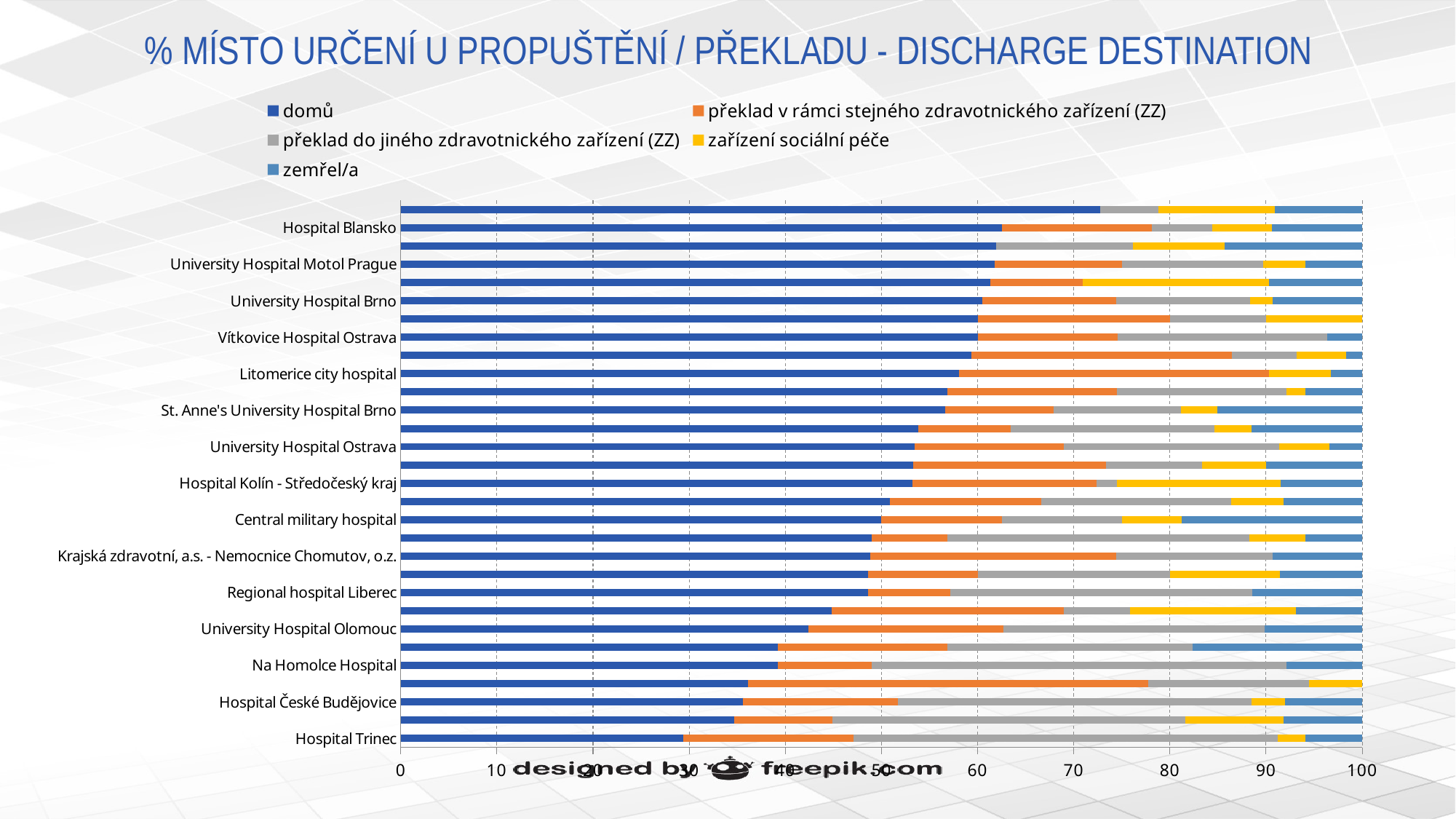
Do the 'domů' values increase or decrease going from the top bar to the bottom bar? decrease Which has a larger 'domů' share, Na Homolce Hospital or University Hospital Brno? University Hospital Brno What value does each stacked bar total on the x axis? 100 Is the 'domů' value for Hospital Blansko greater or less than 60? greater Is the 'domů' value for Hospital České Budějovice greater or less than 40? less What kind of chart is shown on the slide? Stacked bar chart How many series does the legend list? 5 Is the 'domů' value for Hospital Trinec greater or less than 40? less Which labeled hospital has the lowest 'domů' share? Hospital Trinec Which has a larger 'domů' share, Hospital Trinec or Hospital Blansko? Hospital Blansko